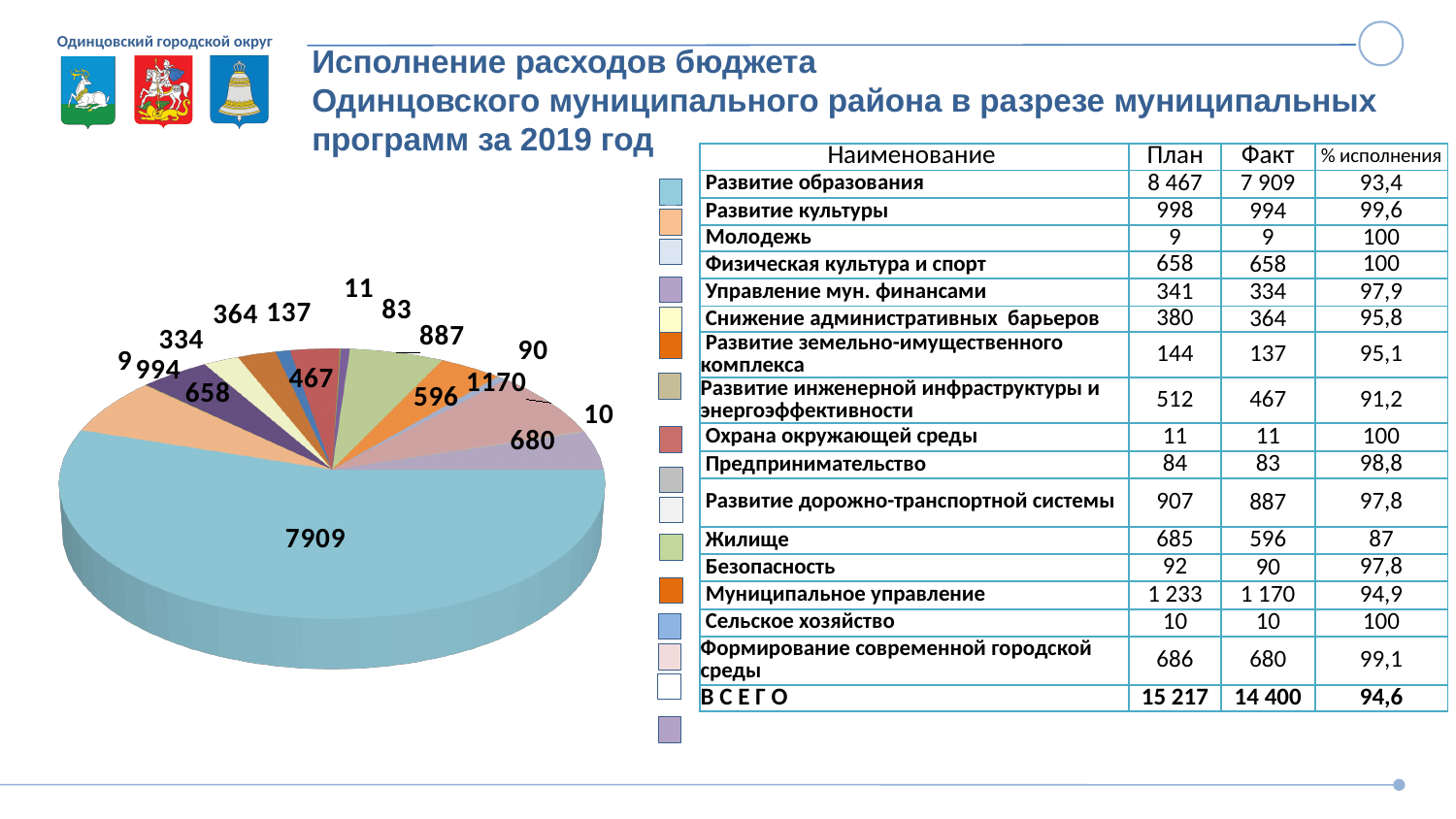
What kind of chart is shown on the slide? pie chart What is the difference between the slice labelled 7909 and the slice labelled 1170? 6739 What colour is the largest slice of the pie chart? light blue What is the value of the pie slice for Жилище? 596 Which is larger on the pie chart: the slice labelled 1170 or the slice labelled 994? 1170 What is the smallest value labelled on the pie chart? 9 How many slices does the pie chart have? 16 What value is labelled on the largest slice of the pie chart? 7909 What is the value of the pie slice for Муниципальное управление? 1170 What is the value of the pie slice for Развитие дорожно-транспортной системы? 887 What is the difference between the slice labelled 887 and the slice labelled 680? 207 Which slice of the pie chart has the largest value? 7909 (Развитие образования)